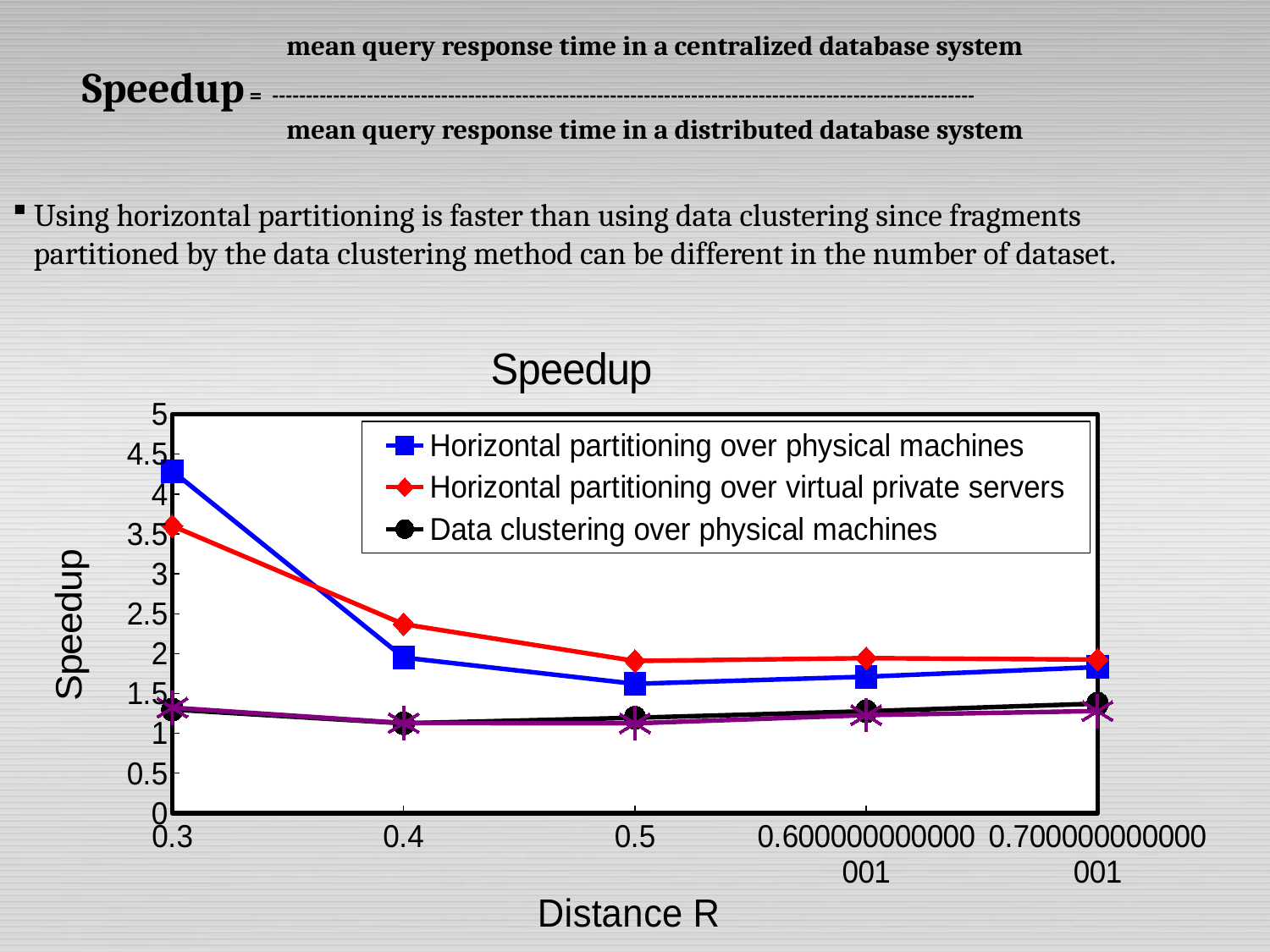
Which series has the highest speedup at Distance R = 0.4? Horizontal partitioning over virtual private servers How many series does the chart's legend list? 3 Which series has the highest speedup at Distance R = 0.3? Horizontal partitioning over physical machines Is the speedup for Horizontal partitioning over virtual private servers at Distance R = 0.3 greater or less than 3? greater At Distance R = 0.5, which is larger: the speedup for Horizontal partitioning over virtual private servers or for Horizontal partitioning over physical machines? Horizontal partitioning over virtual private servers What kind of chart is shown on the slide? line chart Does the speedup for Horizontal partitioning over physical machines rise or fall from Distance R = 0.3 to 0.5? fall What is the label of the x axis of the chart? Distance R Is the speedup for Horizontal partitioning over physical machines at Distance R = 0.3 greater or less than 4? greater Is the speedup for Horizontal partitioning over physical machines at Distance R = 0.5 greater or less than 2? less How many points along the x axis (Distance R) does each series have? 5